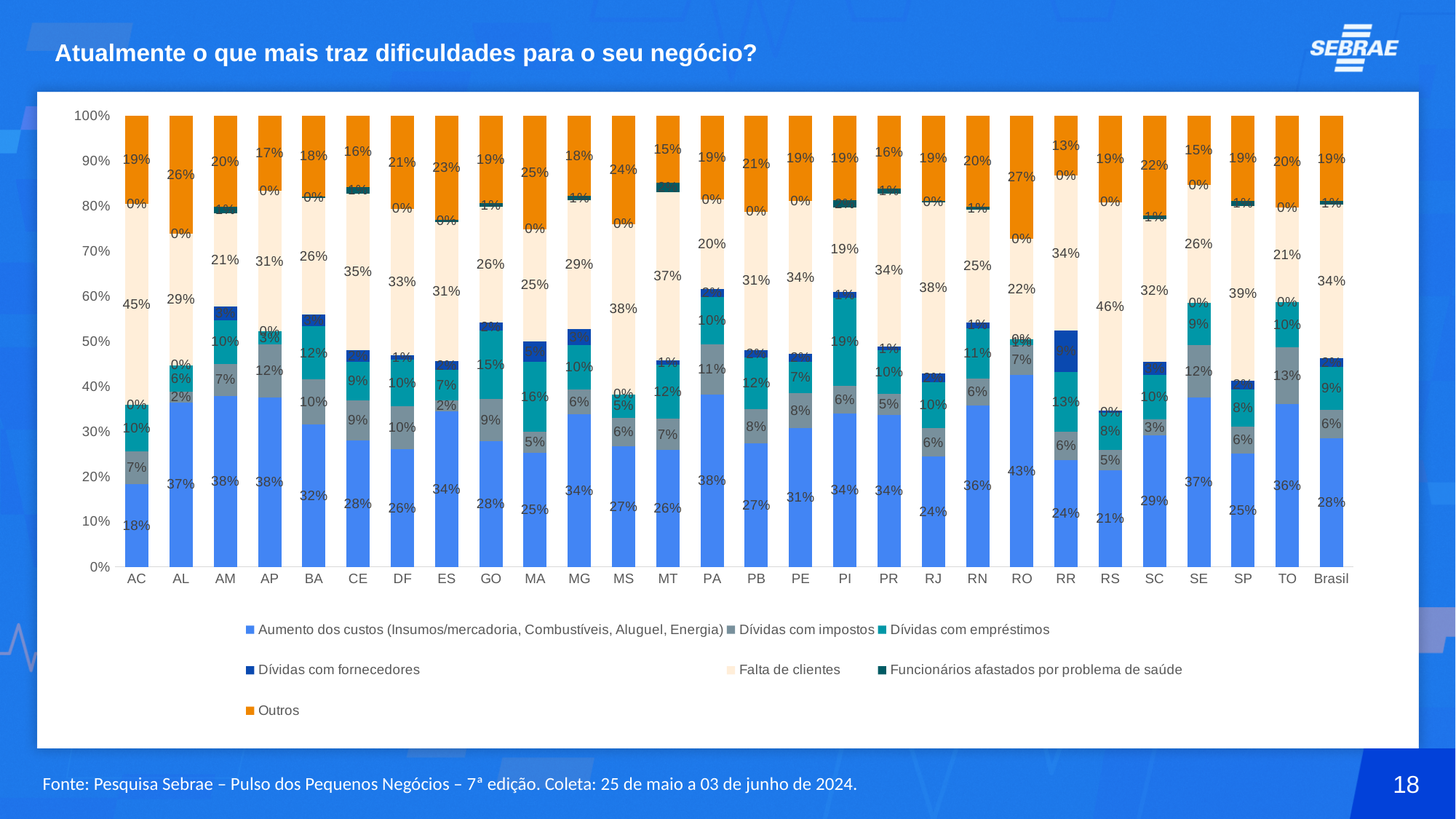
What is the value of 'Aumento dos custos' for RO? 43% What is the value of 'Falta de clientes' for Brasil? 34% What is the value of 'Dívidas com empréstimos' for PI? 19% Which category has the lowest value for 'Aumento dos custos'? AC Which is larger, the 'Falta de clientes' value for AC or for AL? AC Which category has the highest value for 'Aumento dos custos'? RO What kind of chart is shown on the slide? Stacked bar chart What is the difference between the 'Aumento dos custos' values for RO and AC? 25% How many series does the legend list? 7 Which category has the highest value for 'Falta de clientes'? RS How many categories are shown on the x axis? 28 What is the value of 'Outros' for AL? 26%